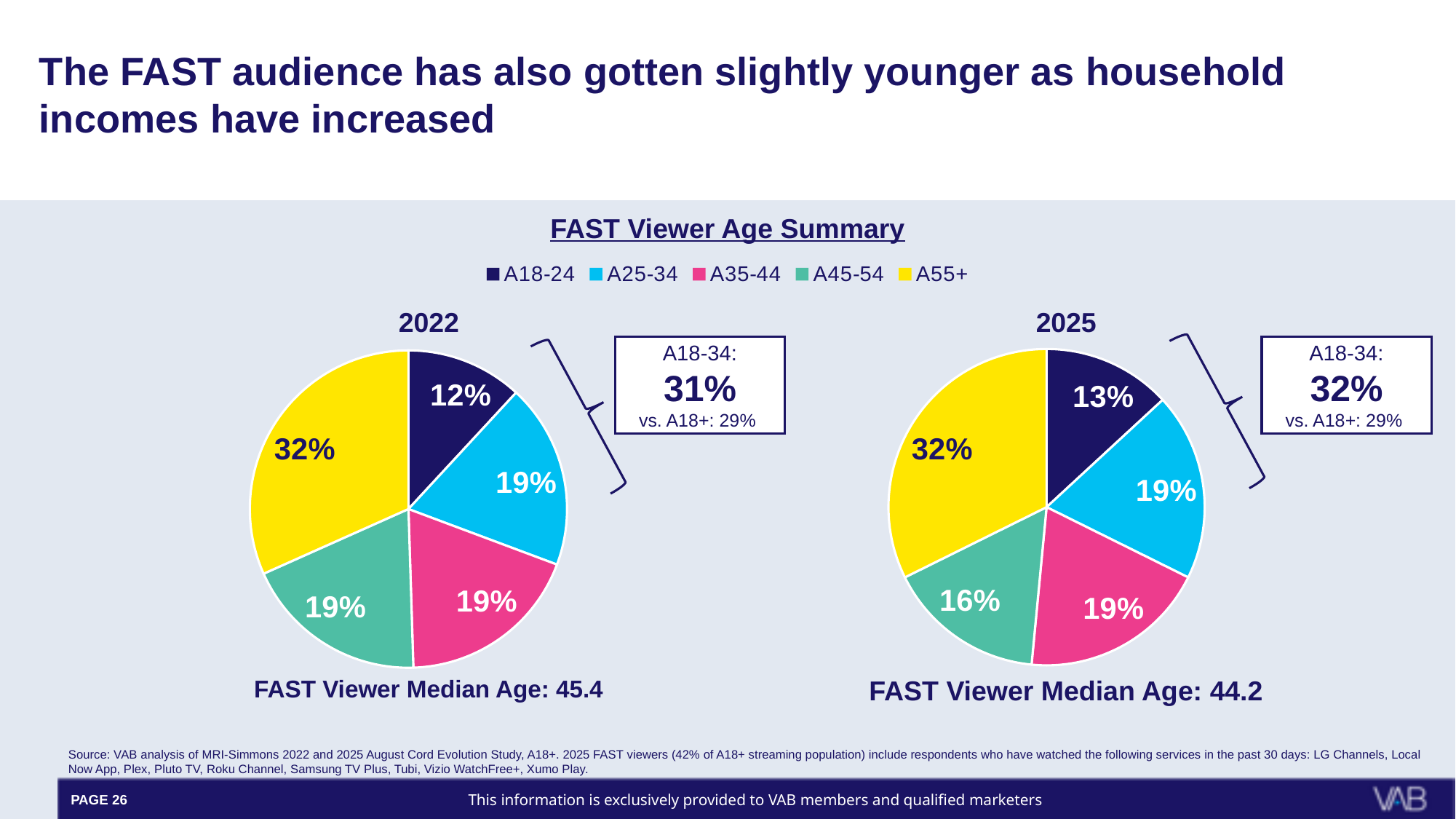
In the 2025 pie chart, which age group has the largest share? A55+ In the 2022 pie chart, which age group has the smallest share? A18-24 In the 2022 pie chart, what share of FAST viewers are A18-24? 12% What is the title shown above the two pie charts? FAST Viewer Age Summary In the 2025 pie chart, what is the difference in percentage points between the A55+ share and the A45-54 share? 16 In the 2022 pie chart, which age group has the largest share? A55+ In the 2025 pie chart, what share of FAST viewers are A45-54? 16% Is the A45-54 share larger in the 2022 pie chart or the 2025 pie chart? 2022 What is the FAST viewer median age shown under the 2025 pie chart? 44.2 How many age groups does the legend list? 5 In the 2025 pie chart, what share of FAST viewers are A18-24? 13% What kind of chart is used to show the 2022 FAST viewer age breakdown? Pie chart